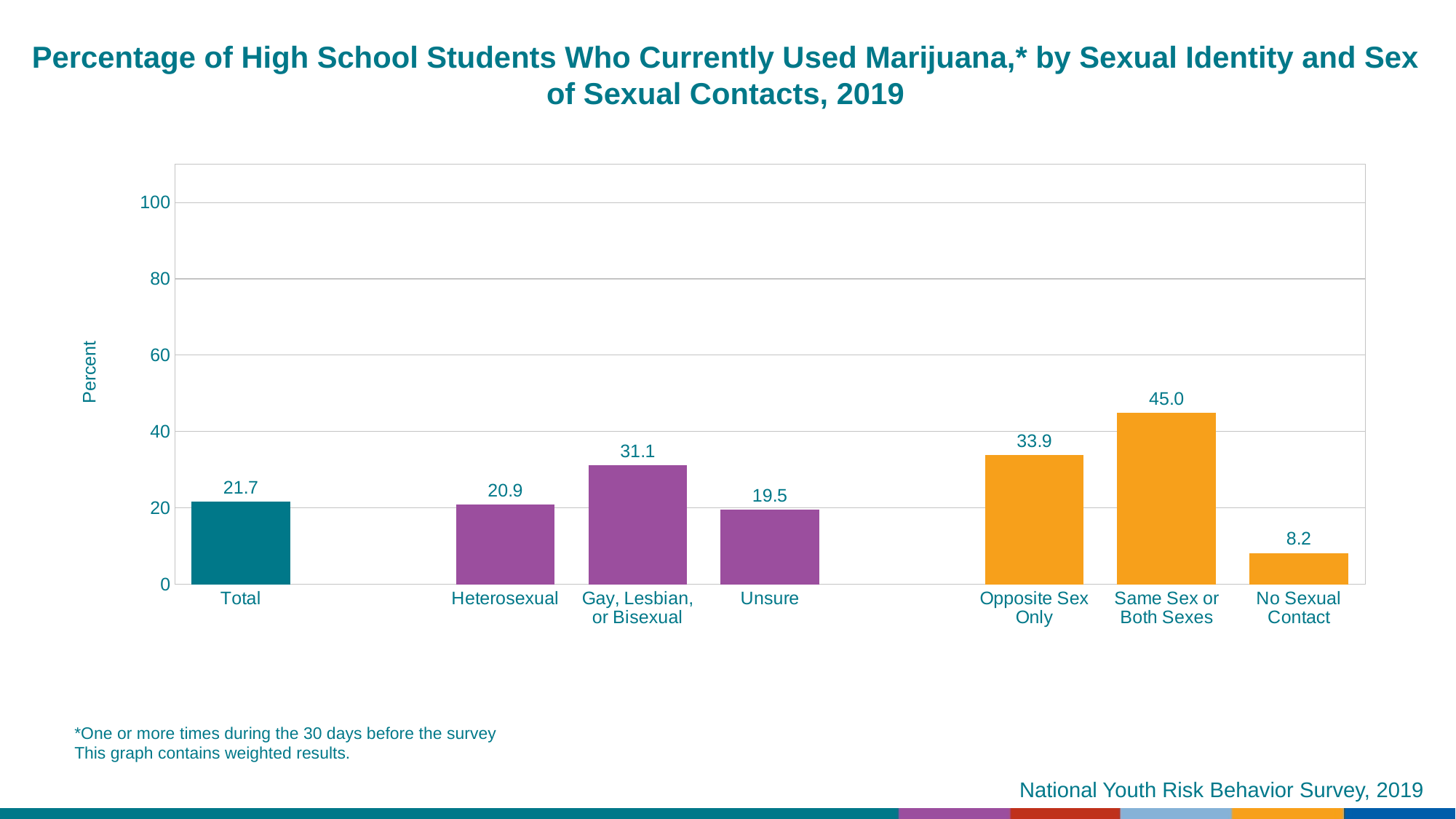
Which category has the lowest value? No Sexual Contact What is the value for Total? 21.7 What kind of chart is shown on the slide? bar chart What is the value for Unsure? 19.5 How many bars are shown in the chart? 7 Which category has the highest value? Same Sex or Both Sexes What is the value for students with No Sexual Contact? 8.2 Which is larger, the value for Heterosexual or the value for Unsure? Heterosexual What is the difference between the values for Gay, Lesbian, or Bisexual and Heterosexual? 10.2 What is the difference between the values for Same Sex or Both Sexes and Opposite Sex Only? 11.1 Is the value for Opposite Sex Only greater or less than 40? less What is the value for Gay, Lesbian, or Bisexual students? 31.1